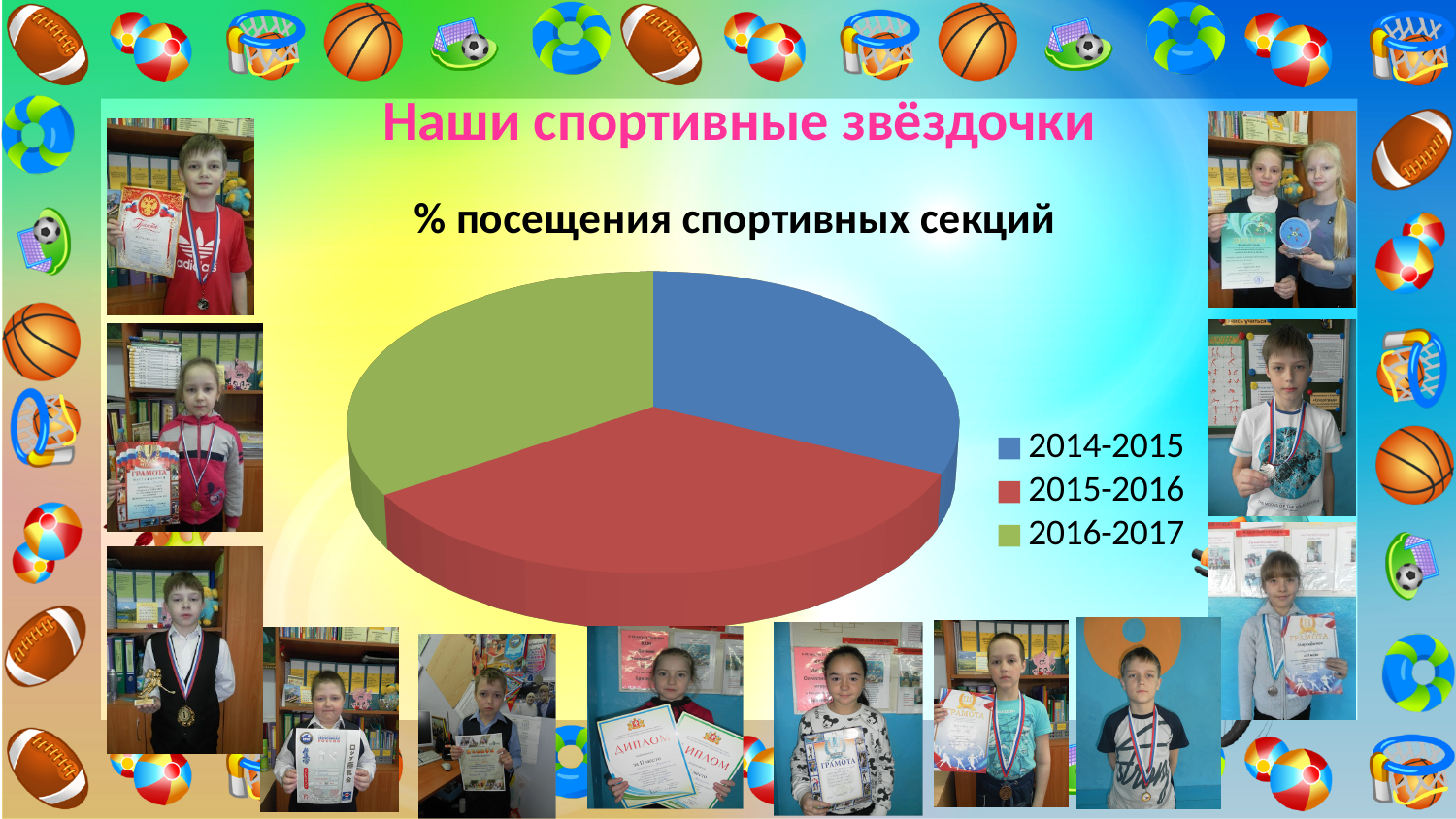
How many entries does the legend of the pie chart list? 3 Which school year does the blue slice of the pie chart represent? 2014-2015 Which school year does the green slice of the pie chart represent? 2016-2017 Which colour represents 2015-2016 in the pie chart? red How many slices does the pie chart have? 3 What kind of chart is shown on the slide? pie chart What is the title of the pie chart? % посещения спортивных секций